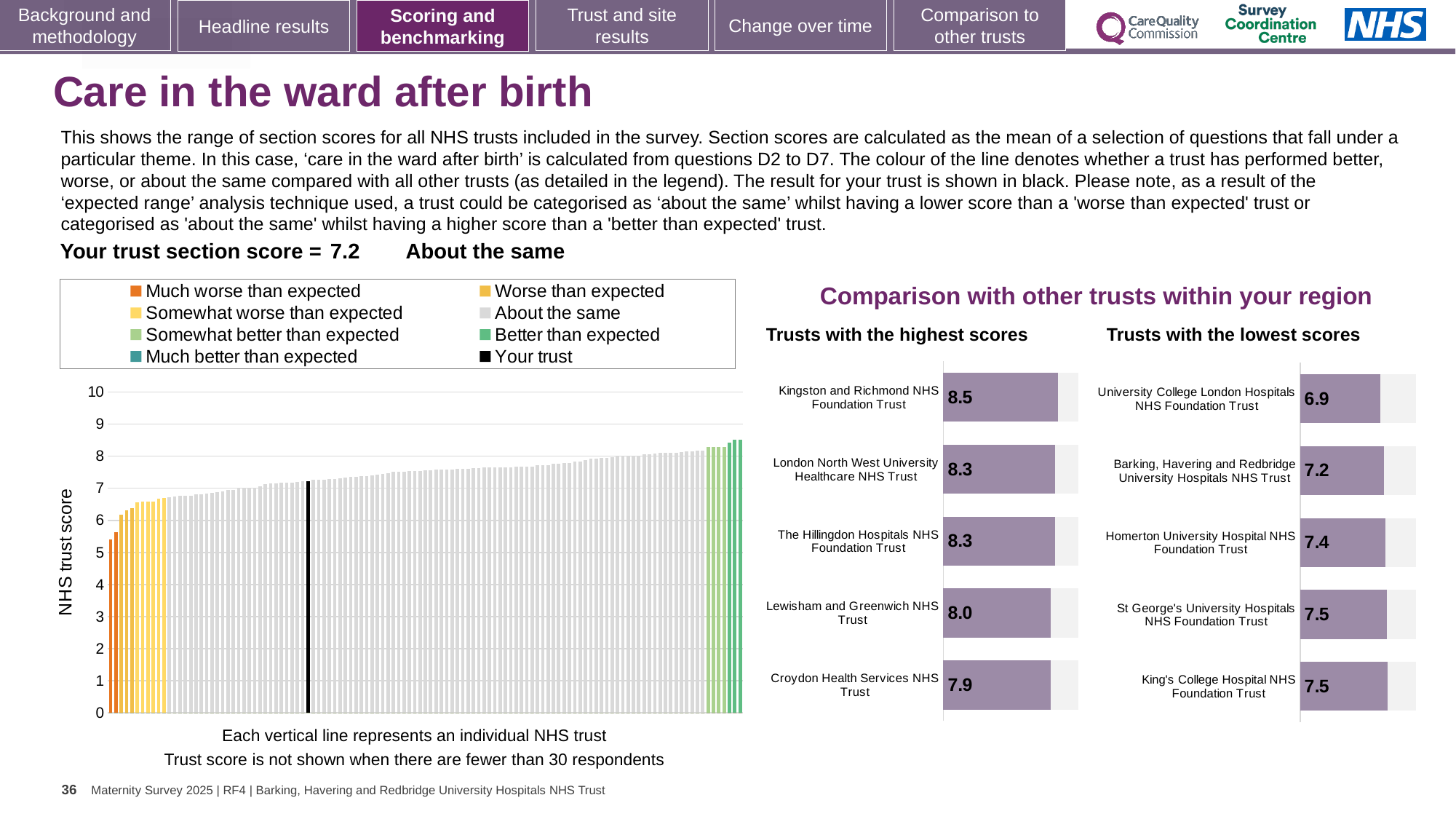
In the 'Trusts with the lowest scores' chart, what is the score for University College London Hospitals NHS Foundation Trust? 6.9 How many entries does the legend of the large chart on the left list? 8 In the 'Trusts with the highest scores' chart, what is the difference between the scores of Kingston and Richmond NHS Foundation Trust and Croydon Health Services NHS Trust? 0.6 In the 'Trusts with the highest scores' chart, which trust has the highest score? Kingston and Richmond NHS Foundation Trust In the 'Trusts with the lowest scores' chart, which has the larger score: Homerton University Hospital NHS Foundation Trust or Barking, Havering and Redbridge University Hospitals NHS Trust? Homerton University Hospital NHS Foundation Trust In the 'Trusts with the highest scores' chart, what is the score for Croydon Health Services NHS Trust? 7.9 What kind of chart is the large chart on the left showing NHS trust scores? Bar chart In the 'Trusts with the lowest scores' chart, what is the difference between the scores of Barking, Havering and Redbridge University Hospitals NHS Trust and University College London Hospitals NHS Foundation Trust? 0.3 How many trusts are listed in the 'Trusts with the lowest scores' chart? 5 In the large chart on the left, do the trust scores rise or fall from left to right? Rise In the 'Trusts with the lowest scores' chart, which trust has the lowest score? University College London Hospitals NHS Foundation Trust In the 'Trusts with the highest scores' chart, what is the score for Kingston and Richmond NHS Foundation Trust? 8.5